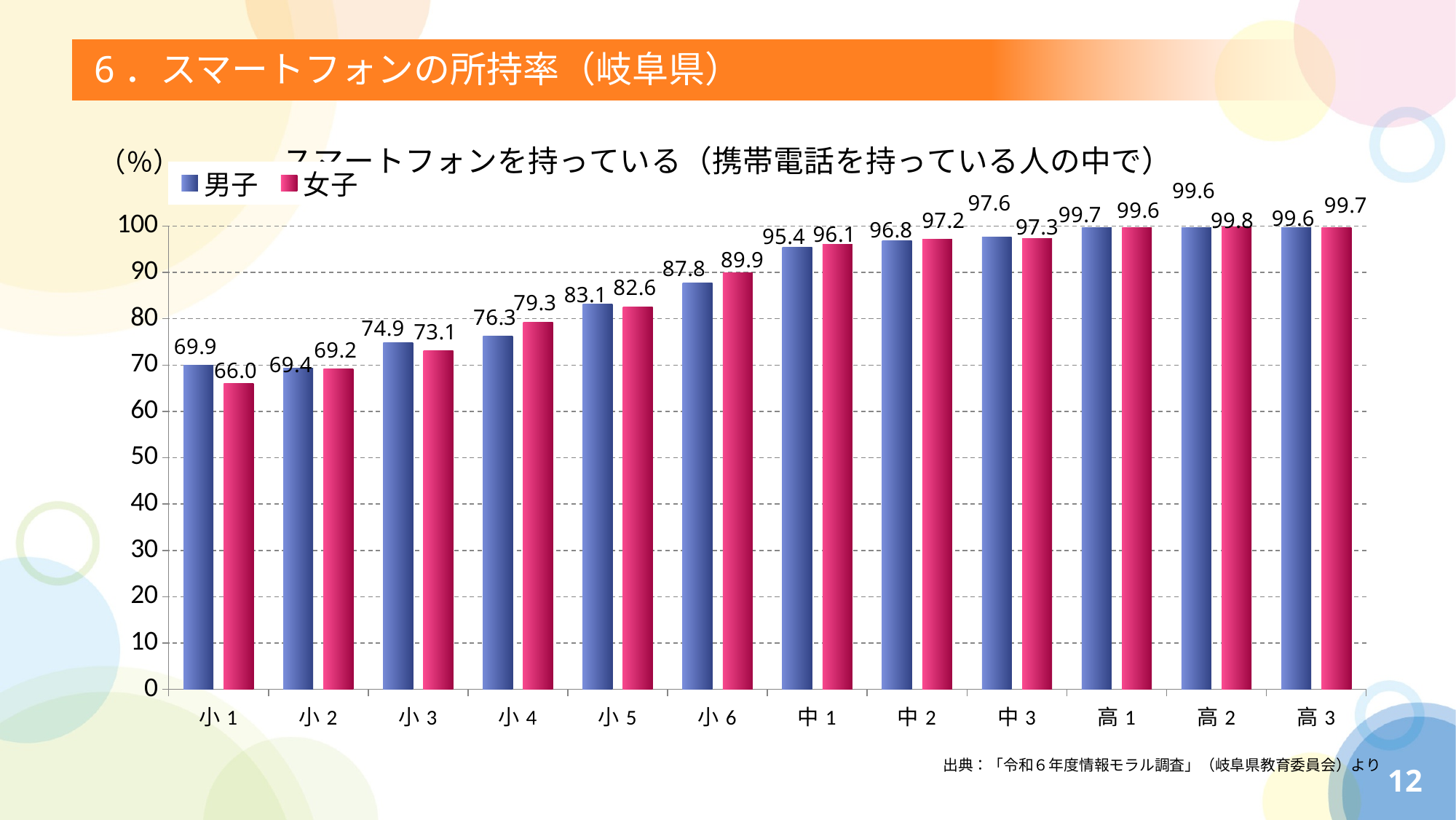
What type of chart is shown on the slide? bar chart Do the values for 女子 generally rise or fall from 小1 to 高3? rise Which grade has the lowest value for 女子? 小1 What is the value for 男子 at 小1? 69.9 Which series is shown in pink in the legend? 女子 How many grade categories are shown on the x axis? 12 Which grade has the lowest value for 男子? 小2 What is the value for 女子 at 小6? 89.9 What is the value for 男子 at 中3? 97.6 What is the difference between 女子 and 男子 at 小4? 3.0 At 小3, which is larger, 男子 or 女子? 男子 How many series does the legend list? 2